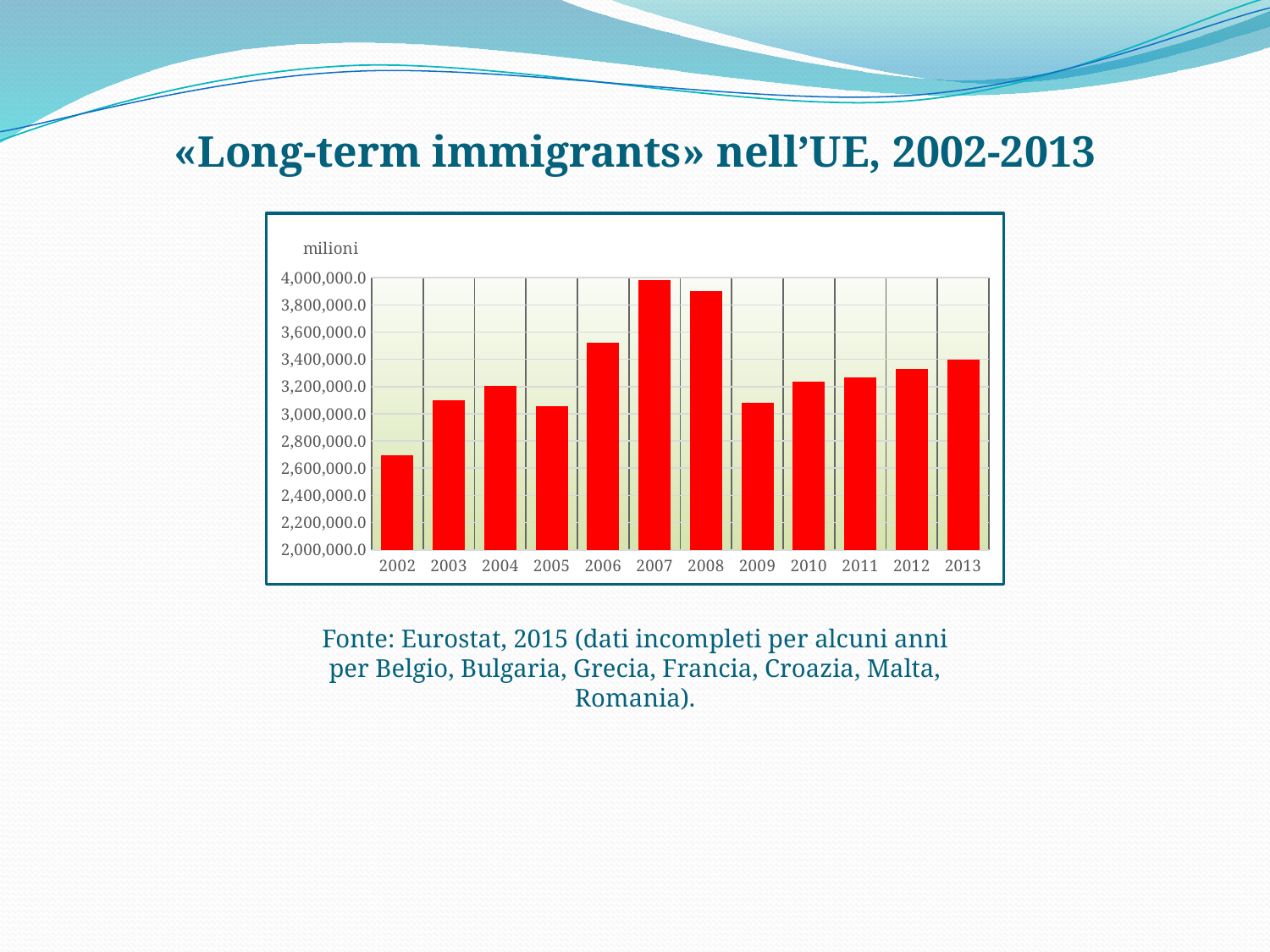
What kind of chart is shown on the slide? bar chart How many years are shown on the x axis of the chart? 12 Which year has the highest number of long-term immigrants? 2007 Do the values rise or fall from 2009 to 2013? rise Is the value for 2002 greater or less than 2,800,000.0? less Which year has the lowest number of long-term immigrants? 2002 What unit label is written above the y axis of the chart? milioni Is the value for 2005 greater or less than 3,200,000.0? less Is the value for 2007 greater or less than 3,800,000.0? greater Which year has the larger value, 2008 or 2010? 2008 Which year has the larger value, 2006 or 2003? 2006